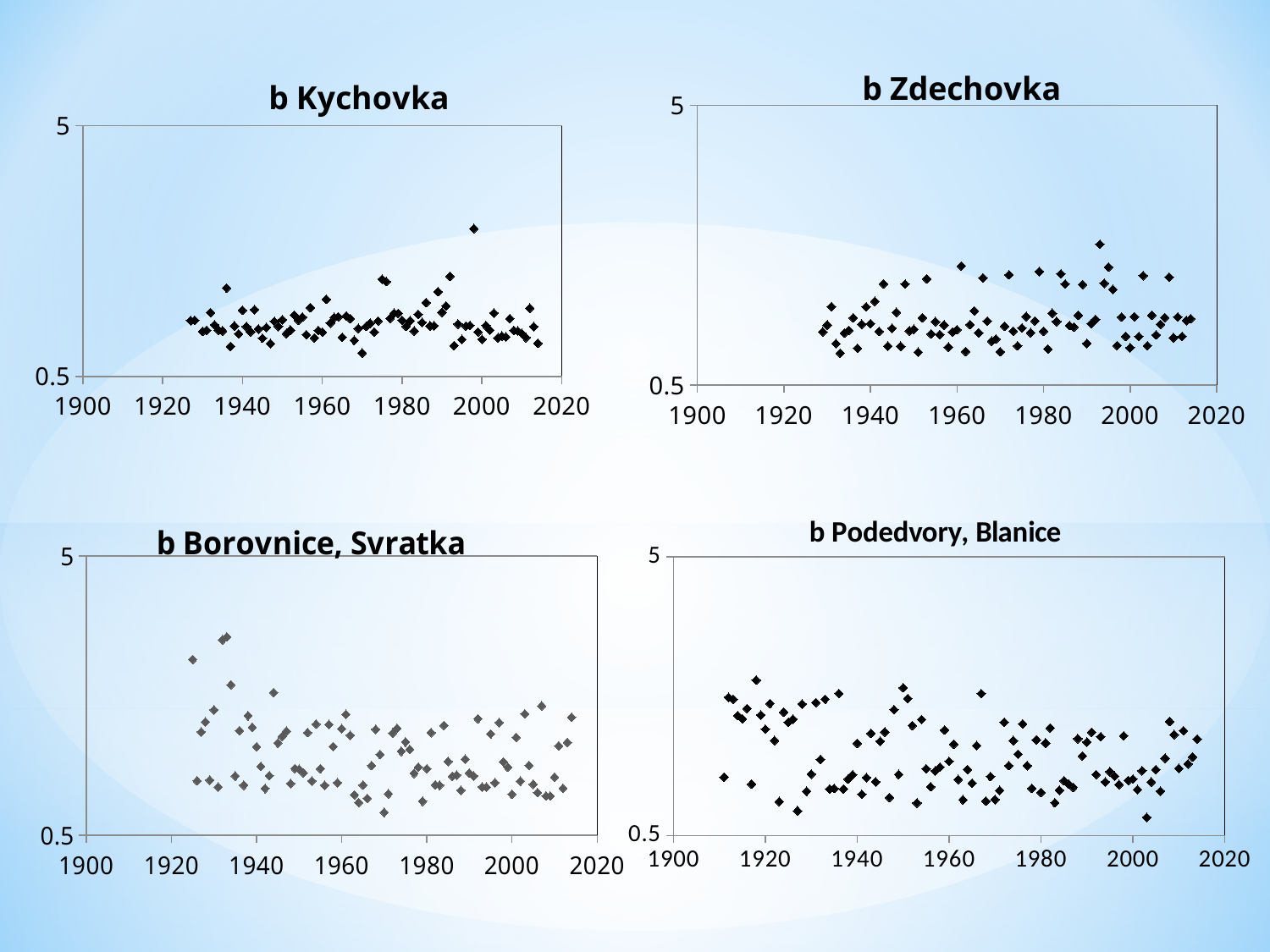
What is the title of the chart in the top-right position? b Zdechovka In the "b Podedvory, Blanice" chart, what is the lowest value shown on the y axis? 0.5 In the "b Zdechovka" chart, what is the highest value shown on the y axis? 5 In the "b Podedvory, Blanice" chart, is the lowest plotted point greater or less than 0.5? greater In the "b Kychovka" chart, what is the last year label on the x axis? 2020 What colour are the data points in the "b Zdechovka" chart? black How many charts are shown on the slide? 4 What is the title of the chart in the bottom-left position? b Borovnice, Svratka In the "b Kychovka" chart, is the highest plotted point greater or less than 5? less Which chart has data points starting earliest, before 1920: "b Kychovka" or "b Podedvory, Blanice"? b Podedvory, Blanice What kind of chart is "b Kychovka"? scatter chart In the "b Borovnice, Svratka" chart, what is the first year label on the x axis? 1900